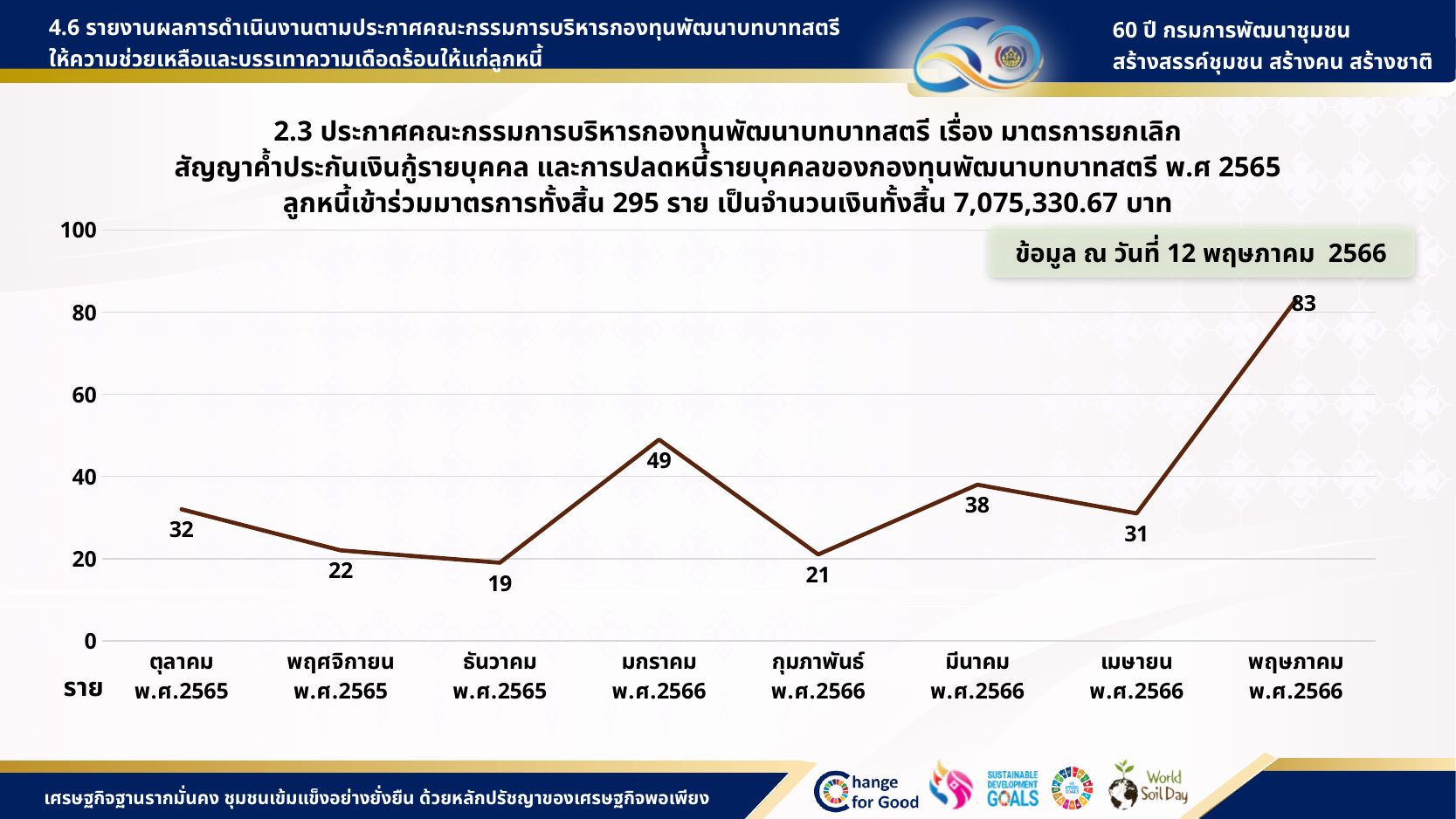
What is the difference between the values for ตุลาคม พ.ศ.2565 and พฤศจิกายน พ.ศ.2565? 10 Does the value rise or fall from เมษายน พ.ศ.2566 to พฤษภาคม พ.ศ.2566? rise Which month has the lowest value? ธันวาคม พ.ศ.2565 What kind of chart is shown on the slide? line chart How many months are plotted on the chart? 8 Is the value for พฤษภาคม พ.ศ.2566 greater or less than 60? greater What is the value for ธันวาคม พ.ศ.2565? 19 Which month has the highest value? พฤษภาคม พ.ศ.2566 What is the difference between the values for พฤษภาคม พ.ศ.2566 and มกราคม พ.ศ.2566? 34 What is the value for เมษายน พ.ศ.2566? 31 Which is larger, the value for มีนาคม พ.ศ.2566 or the value for กุมภาพันธ์ พ.ศ.2566? มีนาคม พ.ศ.2566 What is the value for มกราคม พ.ศ.2566? 49